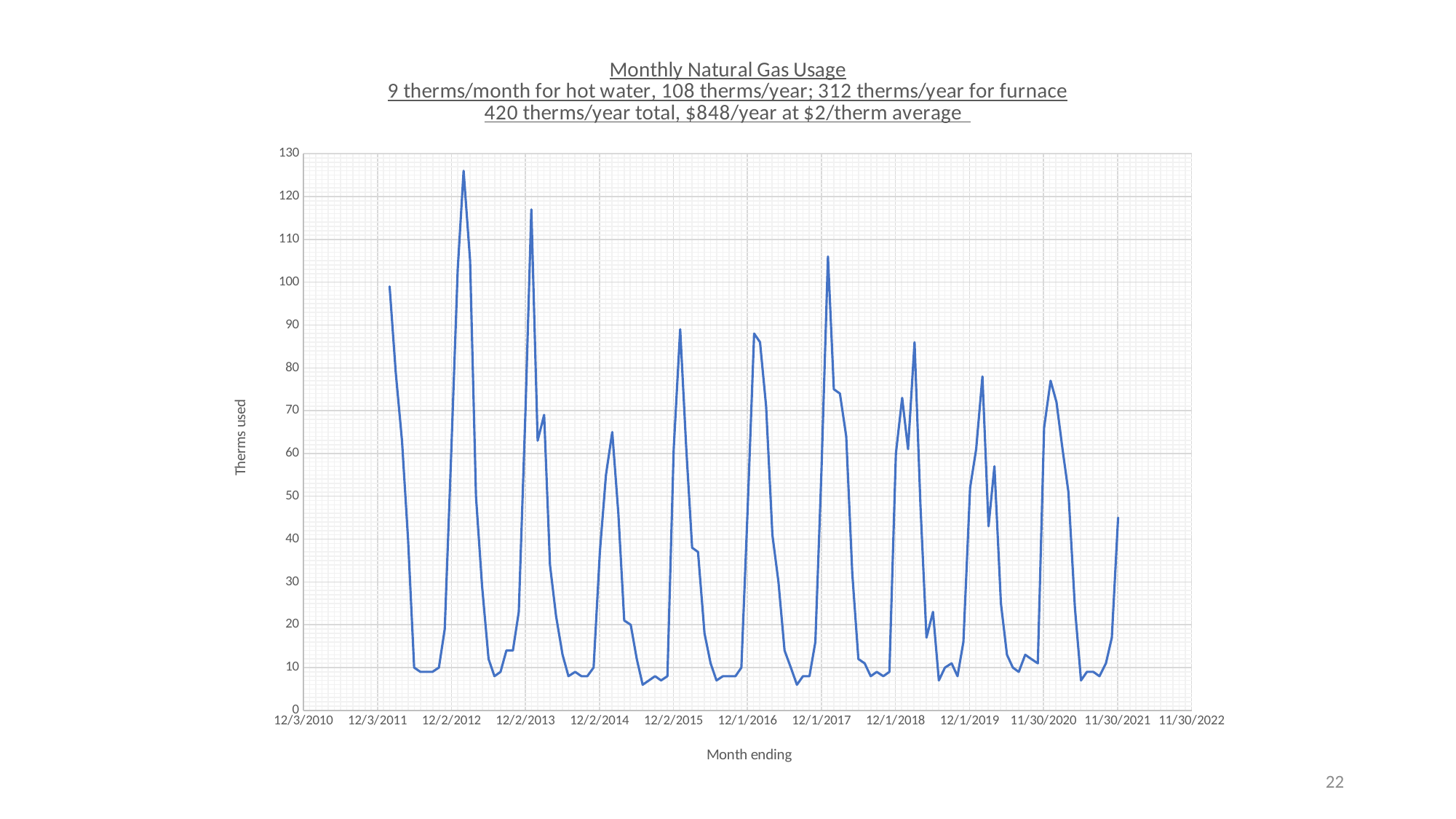
What kind of chart is shown on the slide? line chart Near which x-axis date does the line reach its highest value? 12/2/2012 Is the winter peak just after 12/2/2014 greater or less than 70 therms? less What is the label on the vertical axis of the chart? Therms used Is the winter peak just after 11/30/2020 greater or less than 80 therms? less Are the summer low values on the chart greater or less than 10 therms? less What is the first line of the chart's title? Monthly Natural Gas Usage Which winter peak is higher: the one just after 12/2/2012 or the one just after 12/1/2018? the one just after 12/2/2012 Do the winter peaks generally rise or fall from left to right across the chart? fall